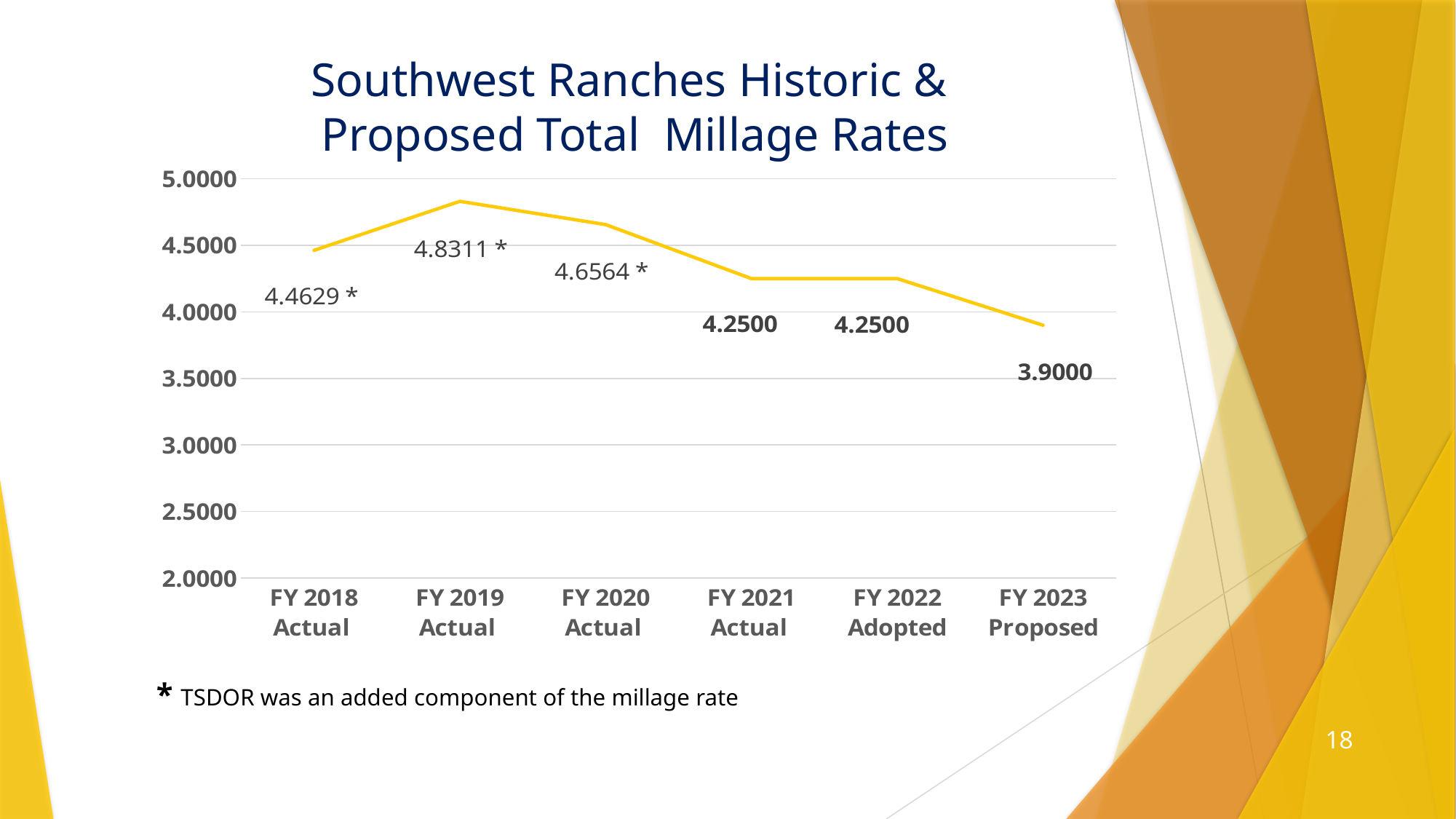
What is the proposed millage rate for FY 2023? 3.9000 Which fiscal year has the highest millage rate? FY 2019 Actual How many fiscal years are plotted on the chart? 6 What kind of chart is shown on the slide? Line chart What is the difference between the FY 2022 Adopted and FY 2023 Proposed millage rates? 0.3500 What is the millage rate for FY 2019 Actual? 4.8311 Does the millage rate rise or fall from FY 2019 Actual to FY 2023 Proposed? Fall What is the millage rate for FY 2022 Adopted? 4.2500 Which is larger, the millage rate for FY 2018 Actual or FY 2020 Actual? FY 2020 Actual What is the millage rate for FY 2018 Actual? 4.4629 What is the difference between the FY 2019 Actual and FY 2020 Actual millage rates? 0.1747 Which fiscal year has the lowest millage rate? FY 2023 Proposed